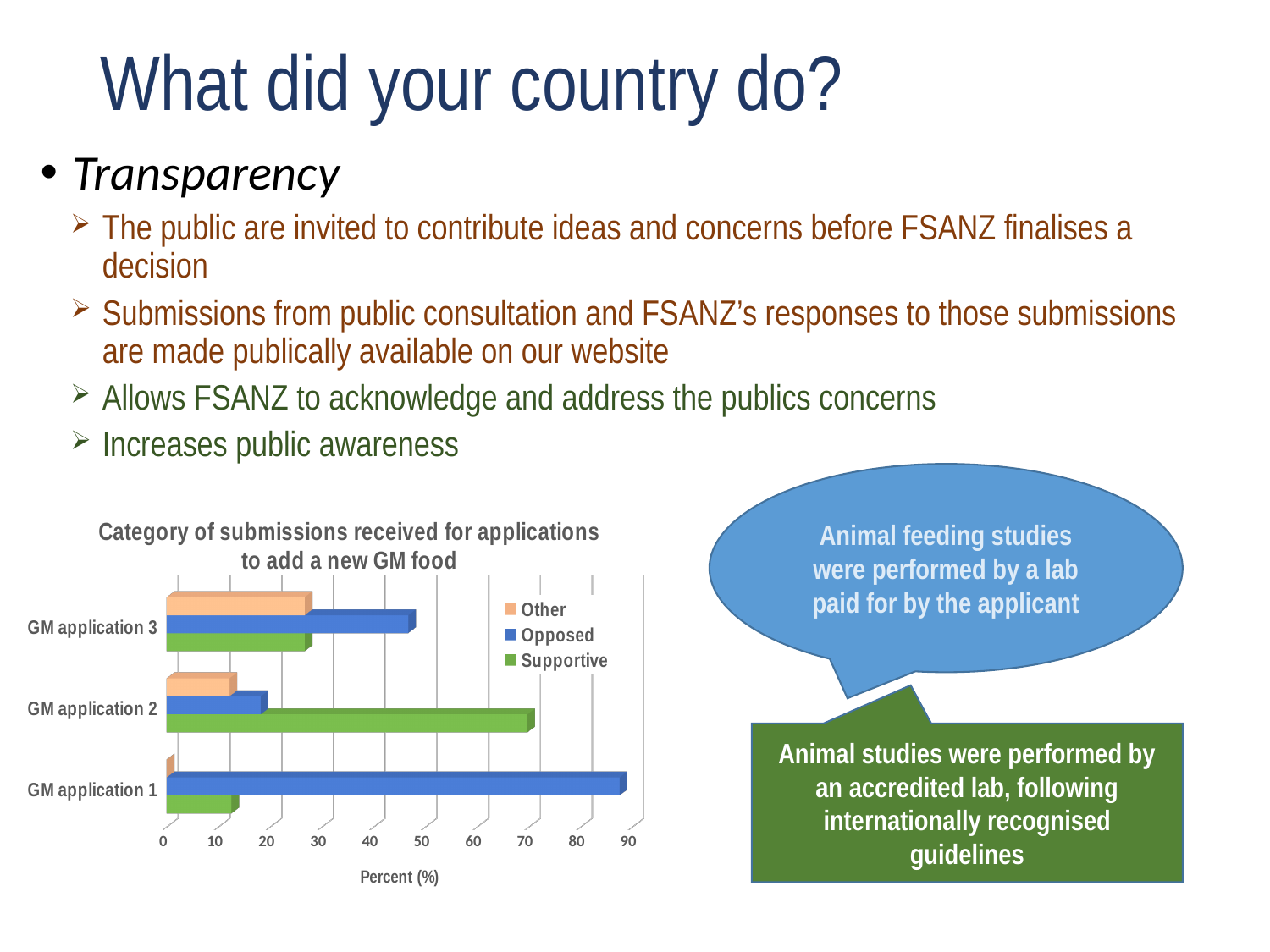
Is the Opposed value for GM application 1 greater or less than 80? greater Which GM application has the highest Opposed value? GM application 1 What is the label on the horizontal axis of the chart? Percent (%) What kind of chart is shown on the slide? Bar chart For GM application 2, which is larger: the Supportive value or the Opposed value? Supportive How many series does the chart legend list? 3 Which GM application has the highest Supportive value? GM application 2 How many GM applications are shown as categories in the chart? 3 For GM application 1, which is larger: the Opposed value or the Supportive value? Opposed Is the Supportive value for GM application 3 greater or less than 40? less Which GM application has the lowest Other value? GM application 1 What is the title of the chart? Category of submissions received for applications to add a new GM food